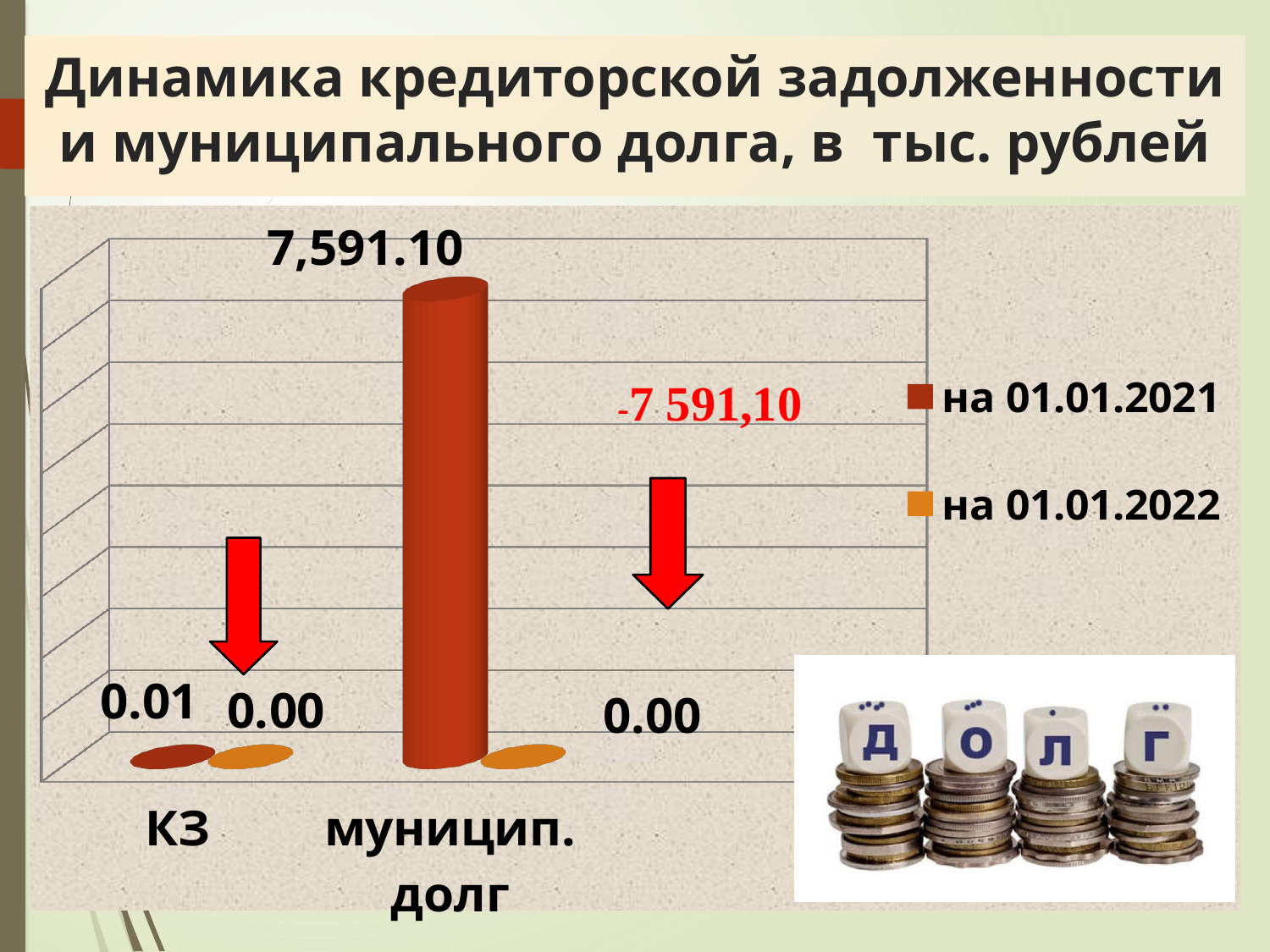
What kind of chart is shown on the slide? bar chart Which is larger: the value for муницип. долг on 01.01.2021 or the value for КЗ on 01.01.2021? муницип. долг on 01.01.2021 What change is written in red next to the arrow for муницип. долг? -7 591,10 What is the value for КЗ in the series на 01.01.2022? 0.00 How many series does the legend list? 2 What is the value for муницип. долг in the series на 01.01.2022? 0.00 How many categories are shown on the x axis of the chart? 2 What is the difference between the муницип. долг values for на 01.01.2021 and на 01.01.2022? 7,591.10 Which category has the highest value in the series на 01.01.2021? муницип. долг What is the value for КЗ in the series на 01.01.2021? 0.01 Which category has the lowest value in the series на 01.01.2021? КЗ What is the value for муницип. долг in the series на 01.01.2021? 7,591.10